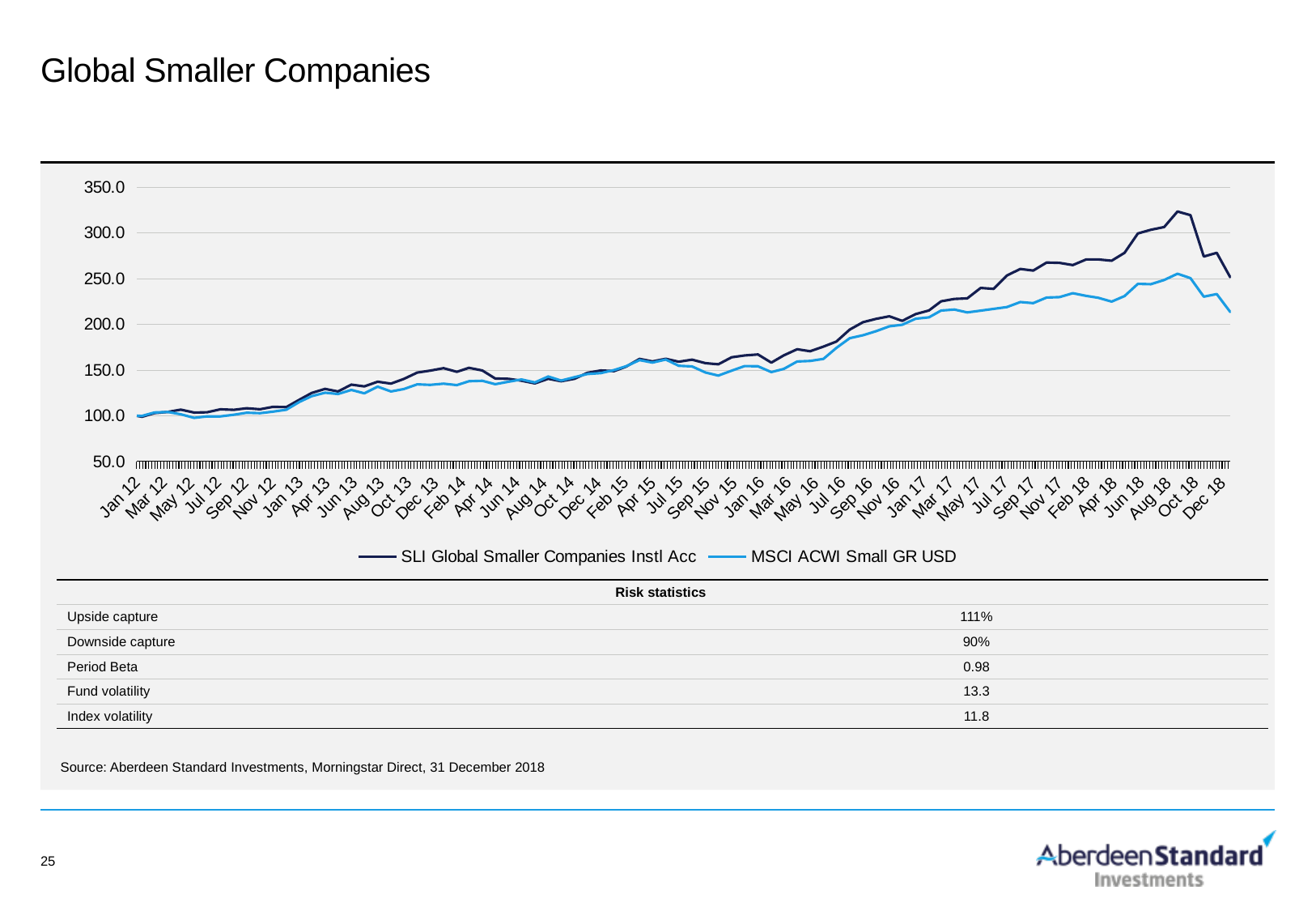
Overall, do the values of the SLI Global Smaller Companies Instl Acc line rise or fall from Jan 12 to Dec 18? Rise Is the value of the MSCI ACWI Small GR USD line at Jan 14 greater or less than 150? less Do the values of both lines rise or fall between Oct 18 and Dec 18? Fall What are the two series named in the chart legend? SLI Global Smaller Companies Instl Acc and MSCI ACWI Small GR USD Is the value of the MSCI ACWI Small GR USD line at Dec 18 greater or less than 250? less How many series does the chart legend list? 2 At Dec 18, which series has the higher value: SLI Global Smaller Companies Instl Acc or MSCI ACWI Small GR USD? SLI Global Smaller Companies Instl Acc Is the peak value of the SLI Global Smaller Companies Instl Acc line around Sep 18 greater or less than 300? greater Which series is drawn in the lighter blue line? MSCI ACWI Small GR USD What kind of chart is shown on the slide? Line chart At Sep 18, which series has the lower value: SLI Global Smaller Companies Instl Acc or MSCI ACWI Small GR USD? MSCI ACWI Small GR USD